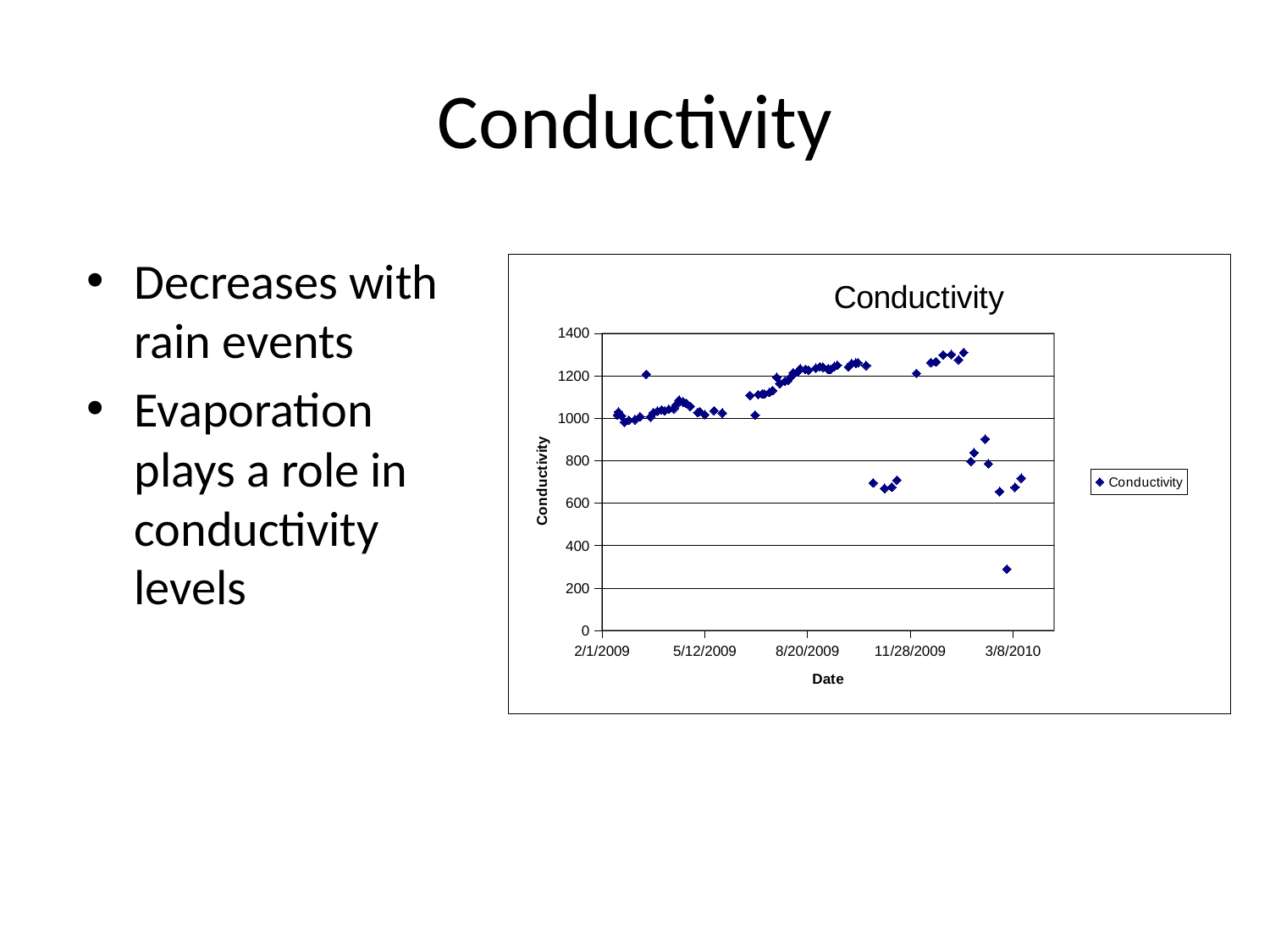
Are the plotted values around 11/28/2009 that sit below the main cluster greater or less than 800? less Is the lowest plotted conductivity value greater or less than 400? less What is the label on the x axis of the chart? Date Is the highest plotted conductivity value greater or less than 1400? less How many series does the chart legend list? 1 What is the maximum value shown on the y axis? 1400 What is the title of the chart? Conductivity What is the last date shown on the x axis? 3/8/2010 What kind of chart is shown on the slide? scatter chart What is the first date shown on the x axis? 2/1/2009